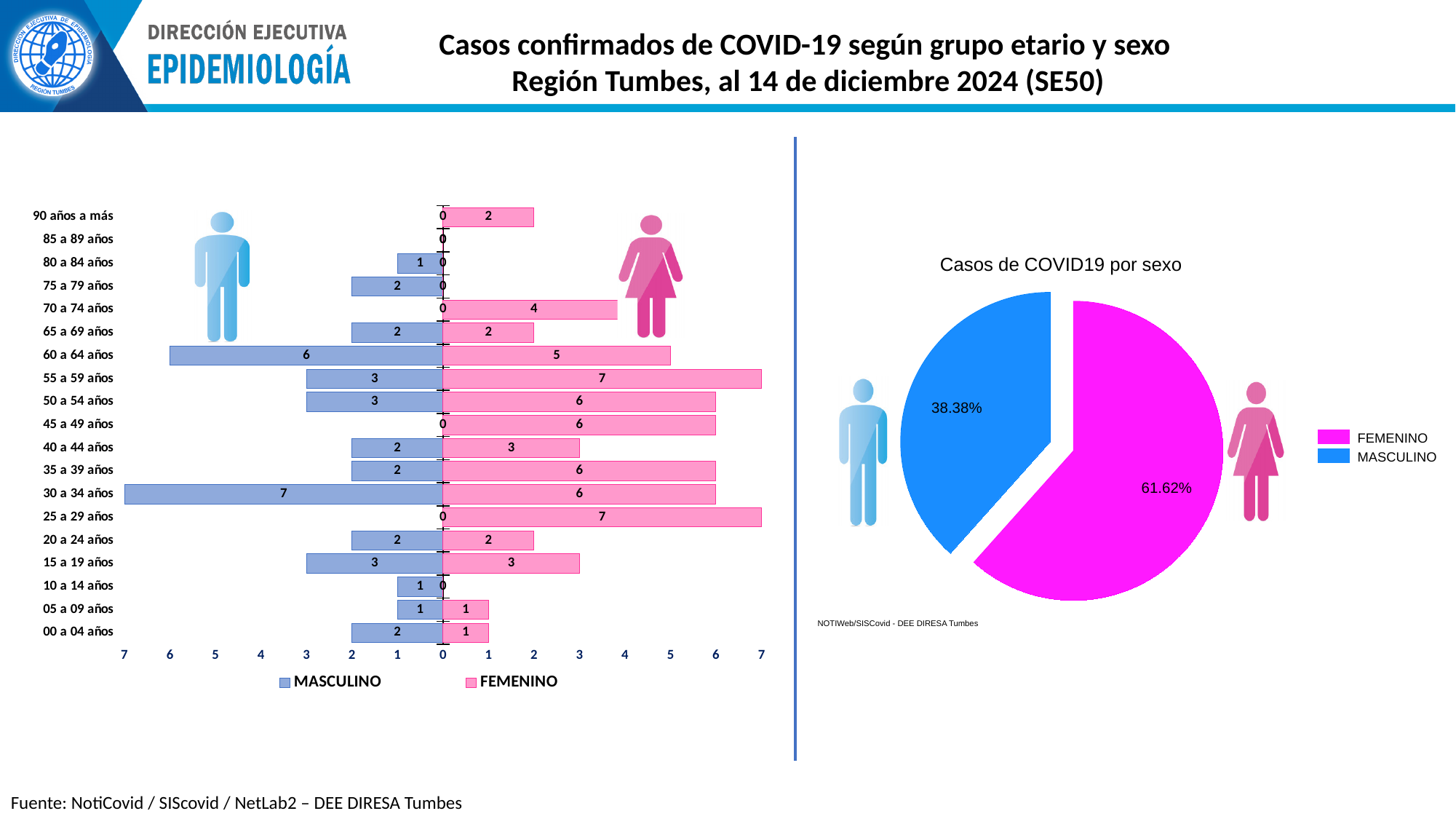
In the left chart, what is the MASCULINO value for the 30 a 34 años age group? 7 In the pie chart 'Casos de COVID19 por sexo', which slice is larger, FEMENINO or MASCULINO? FEMENINO How many age groups are shown in the left chart? 19 In the pie chart 'Casos de COVID19 por sexo', what share is MASCULINO? 38.38% In the left chart, what is the difference between the FEMENINO and MASCULINO values for the 55 a 59 años age group? 4 What kind of chart is the left chart? bar chart In the pie chart 'Casos de COVID19 por sexo', what share is FEMENINO? 61.62% How many series does the legend of the left chart list? 2 In the left chart, what is the FEMENINO value for the 50 a 54 años age group? 6 In the left chart, which is larger for the 60 a 64 años age group, MASCULINO or FEMENINO? MASCULINO In the left chart, what is the FEMENINO value for the 70 a 74 años age group? 4 In the left chart, which age group has the highest MASCULINO value? 30 a 34 años